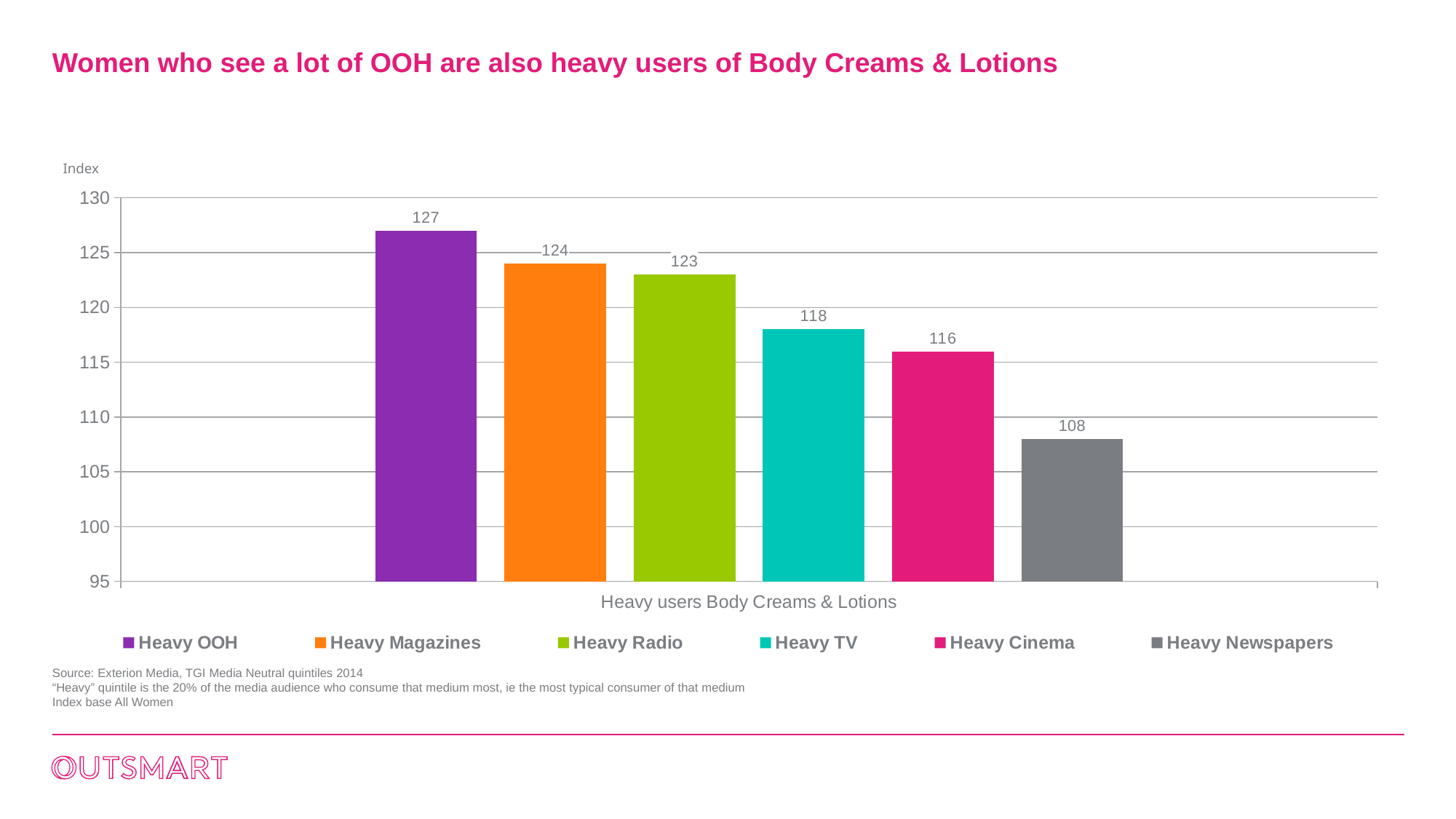
What is the index value for Heavy Newspapers? 108 Which series has the highest index value? Heavy OOH What kind of chart is shown on the slide? Bar chart What is the index value for Heavy OOH? 127 Is the value for Heavy Cinema greater or less than 120? less What is the index value for Heavy TV? 118 What colour is the bar for Heavy Magazines? Orange How many series does the legend list? 6 Which has a higher index value, Heavy Radio or Heavy TV? Heavy Radio Which series has the lowest index value? Heavy Newspapers What is the difference between the index values for Heavy OOH and Heavy Newspapers? 19 What is the difference between the index values for Heavy Magazines and Heavy Cinema? 8